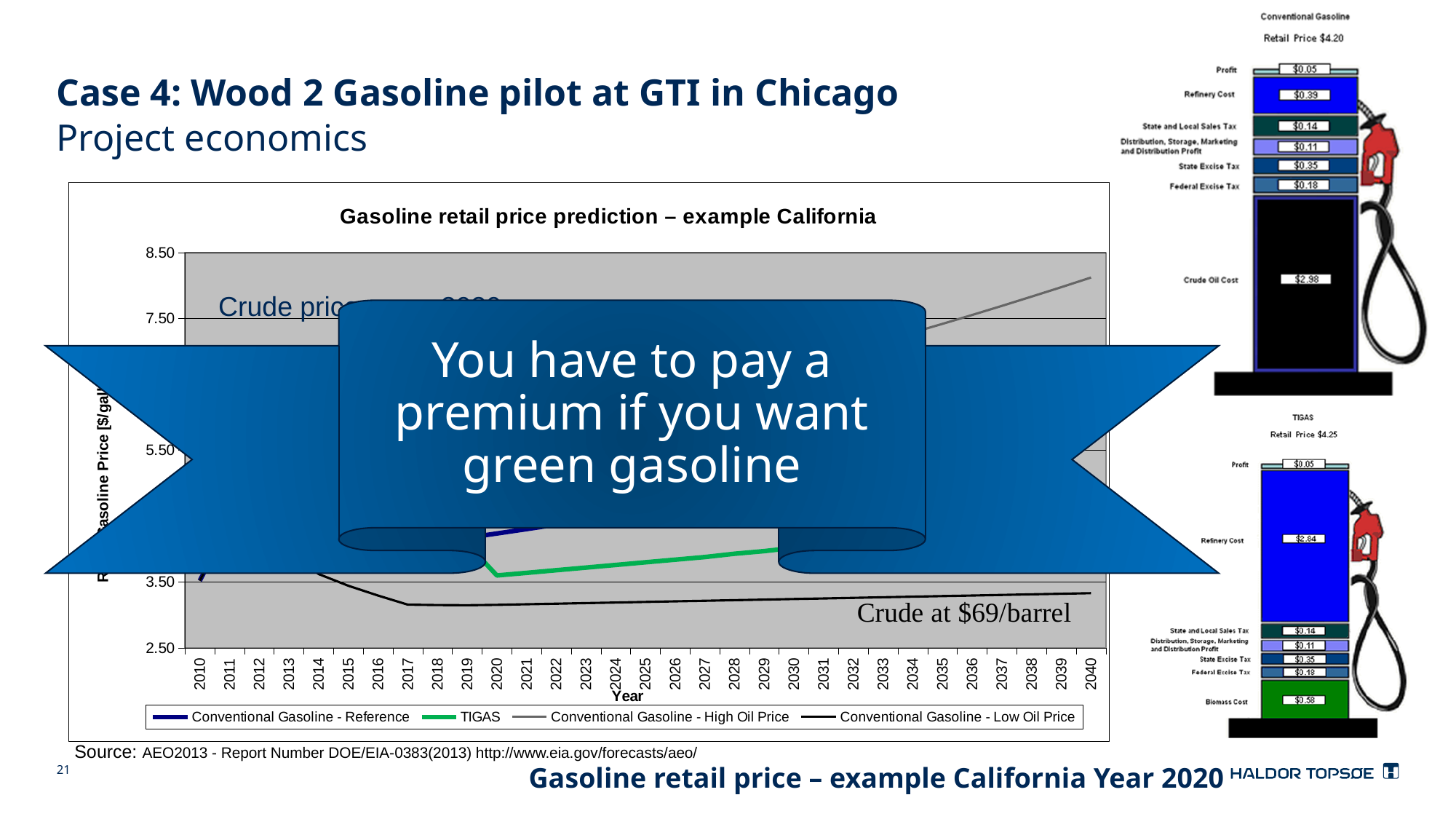
In the 'Gasoline retail price prediction – example California' chart, is the value of 'Conventional Gasoline - Low Oil Price' in 2040 greater or less than 3.50? less In the 'Conventional Gasoline' pump chart on the right, what is the Crude Oil Cost? $2.98 In the 'Gasoline retail price prediction – example California' chart, is the value of 'Conventional Gasoline - High Oil Price' in 2040 greater or less than 7.50? greater In the 'Gasoline retail price prediction – example California' chart, what is the label of the x axis? Year In the 'Gasoline retail price prediction – example California' chart, does the 'Conventional Gasoline - High Oil Price' line rise or fall from 2035 to 2040? rise What is the difference between the TIGAS retail price ($4.25) and the Conventional Gasoline retail price ($4.20) in the pump charts on the right? $0.05 What kind of chart is 'Gasoline retail price prediction – example California'? line chart In the 'Conventional Gasoline' pump chart on the right, what is the retail price shown? $4.20 How many series does the legend of the 'Gasoline retail price prediction – example California' chart list? 4 In the 'TIGAS' pump chart on the right, what is the retail price shown? $4.25 In the 'TIGAS' pump chart on the right, which cost component is the largest? Refinery Cost In the 'Gasoline retail price prediction – example California' chart, which series is drawn in green? TIGAS